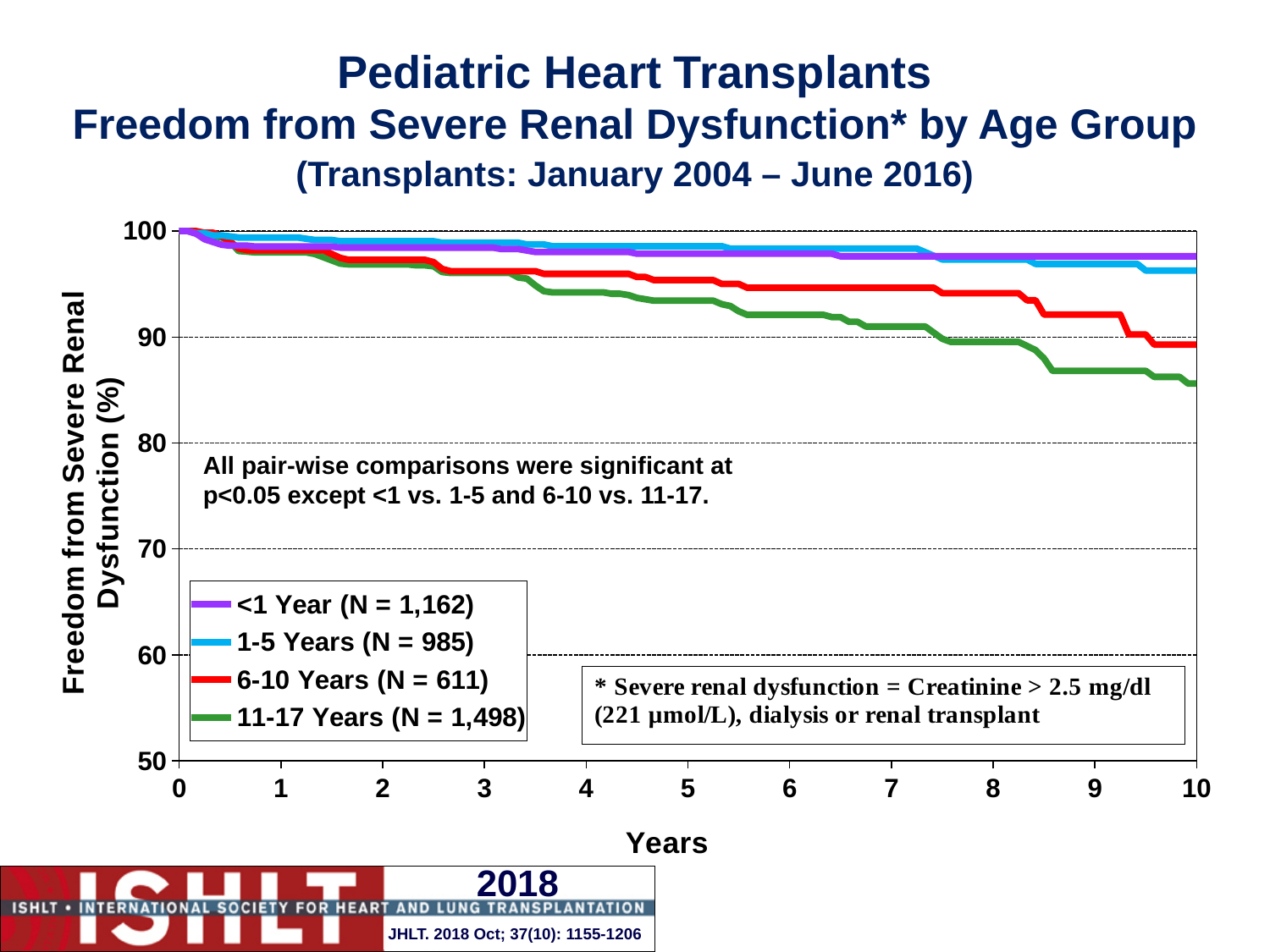
Which age group has the highest freedom from severe renal dysfunction at year 10? <1 Year Is the value for 11-17 Years at year 10 greater or less than 90? less What value do all the curves start at in year 0? 100 What is the N for the 11-17 Years group shown in the legend? 1,498 At year 10, which is larger: the value for 6-10 Years or the value for 11-17 Years? 6-10 Years How many series does the legend list? 4 Do the curves rise or fall as years increase? fall Is the value for 6-10 Years at year 8 greater or less than 90? greater What is the label of the y axis? Freedom from Severe Renal Dysfunction (%) Which age group has the lowest freedom from severe renal dysfunction at year 10? 11-17 Years Is the value for <1 Year at year 10 greater or less than 90? greater What kind of chart is shown on the slide? line chart